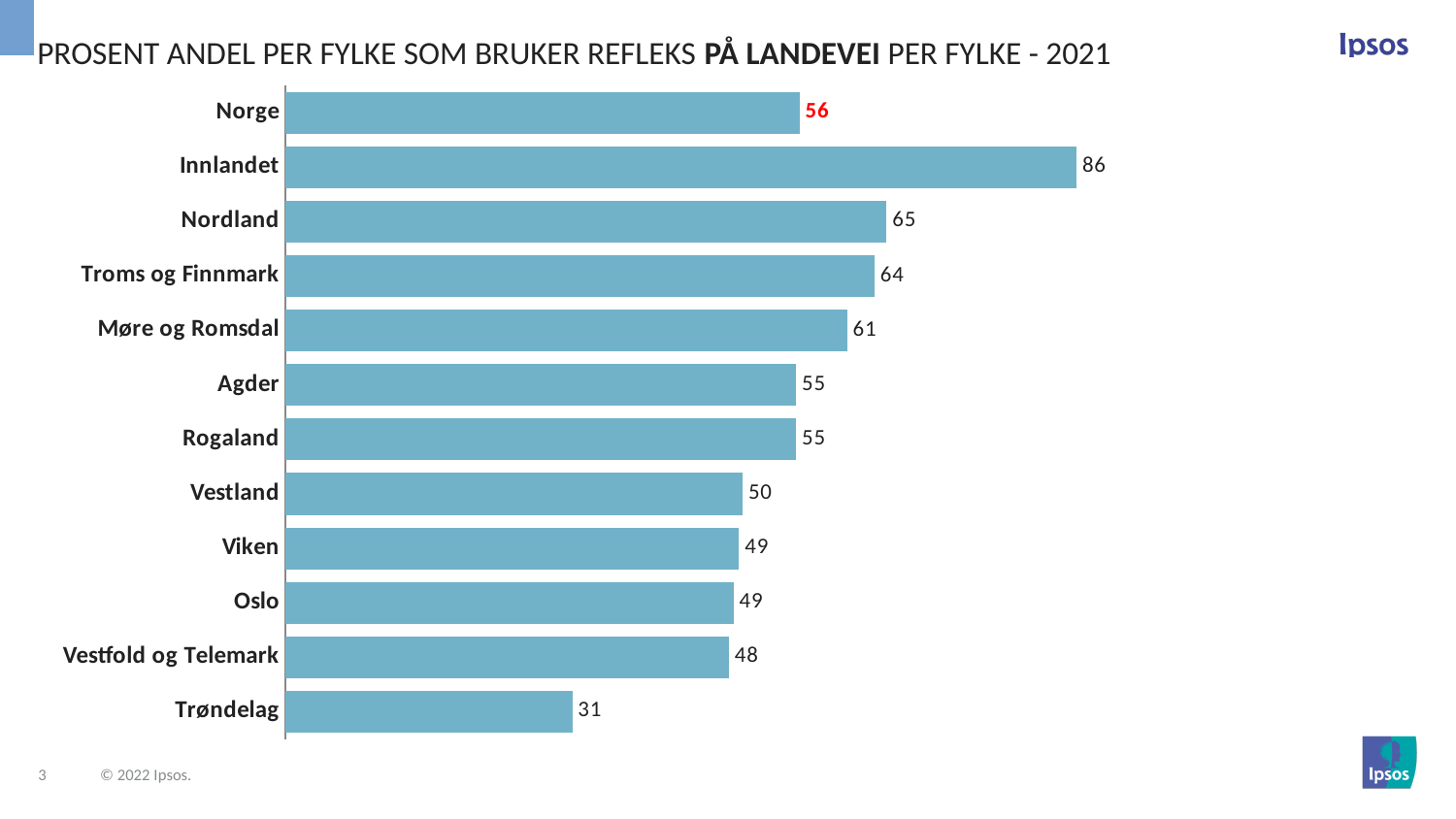
How many categories are shown in the chart? 12 What is the value for Trøndelag? 31 Which category has the highest value? Innlandet What is the difference between the values for Innlandet and Trøndelag? 55 Which is larger, the value for Møre og Romsdal or the value for Agder? Møre og Romsdal Which category has the lowest value? Trøndelag What is the value for Innlandet? 86 What kind of chart is shown on the slide? bar chart What is the value for Norge? 56 Which category's data label is shown in red? Norge What is the value for Troms og Finnmark? 64 What is the difference between the values for Nordland and Vestland? 15